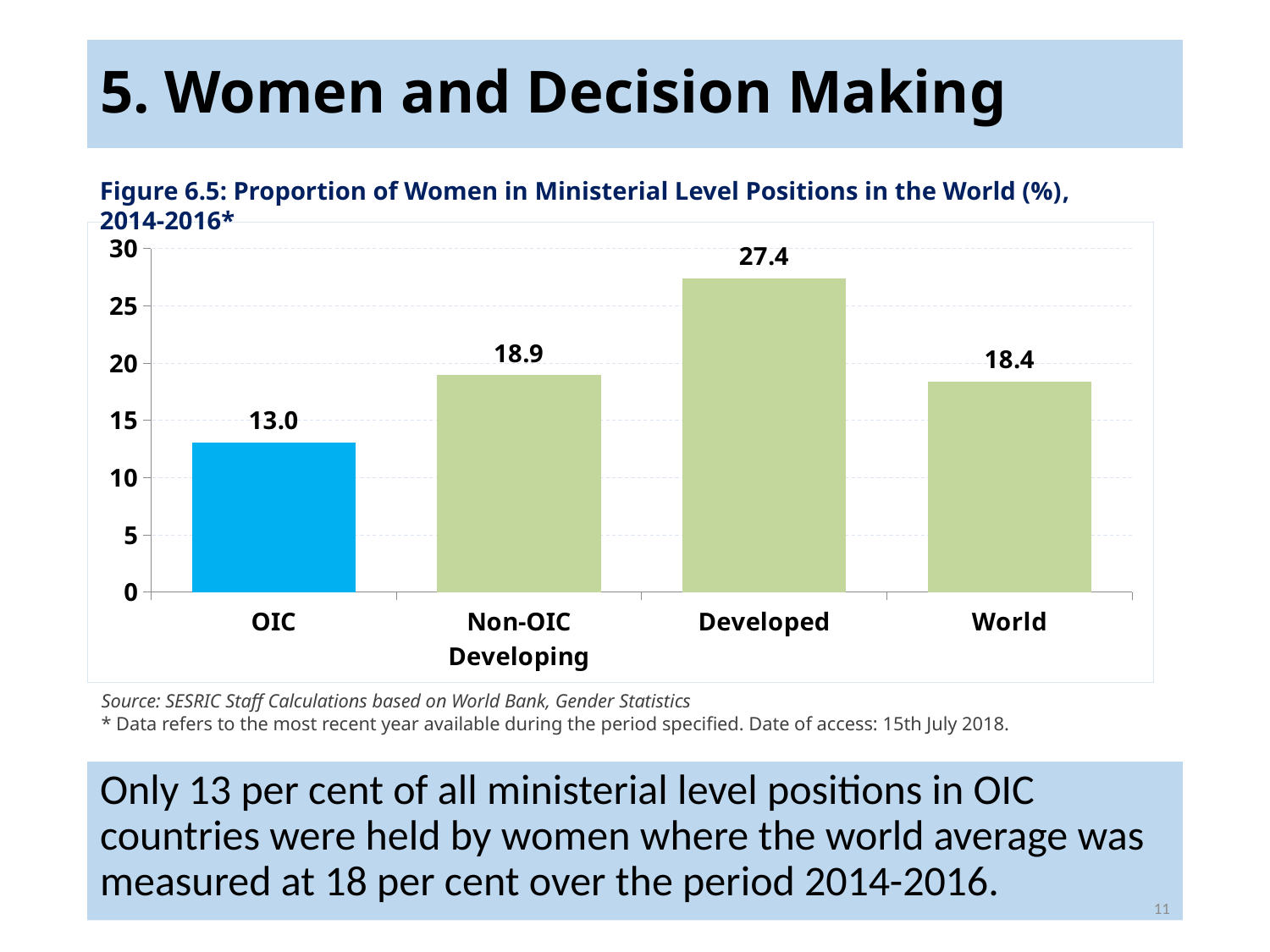
What is the difference between the values for Non-OIC Developing and World? 0.5 Which category has the lowest value? OIC Which category has the highest value? Developed What is the value for Developed? 27.4 What is the value for OIC? 13.0 Is the value for OIC greater or less than 15? less What is the value for World? 18.4 What is the difference between the values for Developed and OIC? 14.4 What is the value for Non-OIC Developing? 18.9 What kind of chart is shown on the slide? bar chart Which is larger, the value for Developed or the value for World? Developed How many categories are shown on the x axis? 4